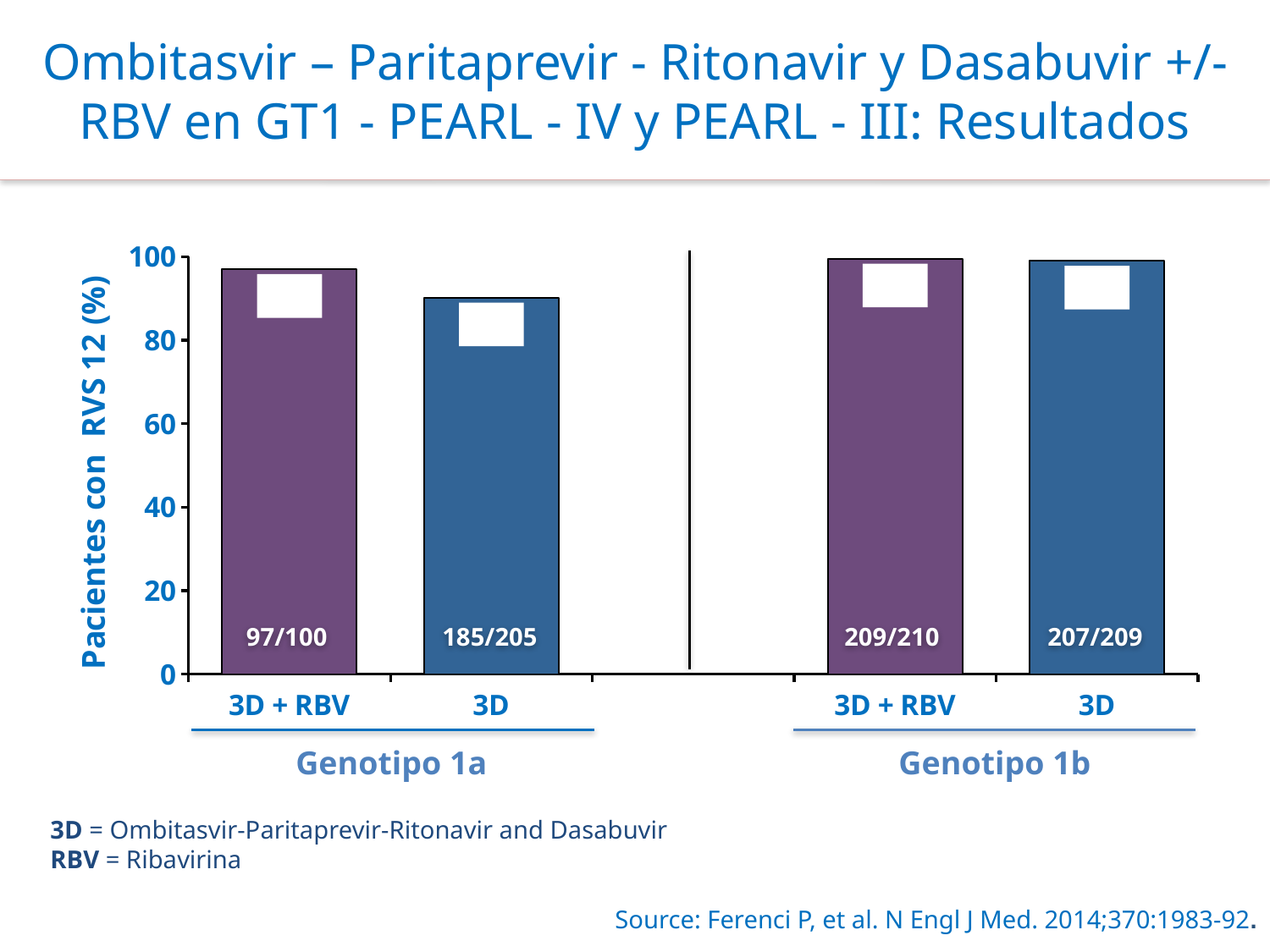
What kind of chart is shown on the slide? Bar chart What label is printed on the 3D bar for Genotipo 1a? 185/205 Which bar shows the lowest percentage of patients with RVS 12? 3D in Genotipo 1a How many genotype groups are shown on the x axis? 2 What is the label of the y axis? Pacientes con RVS 12 (%) Is the value for 3D in Genotipo 1a greater or less than 100? less What label is printed on the 3D + RBV bar for Genotipo 1a? 97/100 In Genotipo 1a, which bar is taller: 3D + RBV or 3D? 3D + RBV What label is printed on the 3D + RBV bar for Genotipo 1b? 209/210 Is the value for 3D in Genotipo 1a greater or less than 80? greater How many bars are plotted in the chart? 4 What label is printed on the 3D bar for Genotipo 1b? 207/209